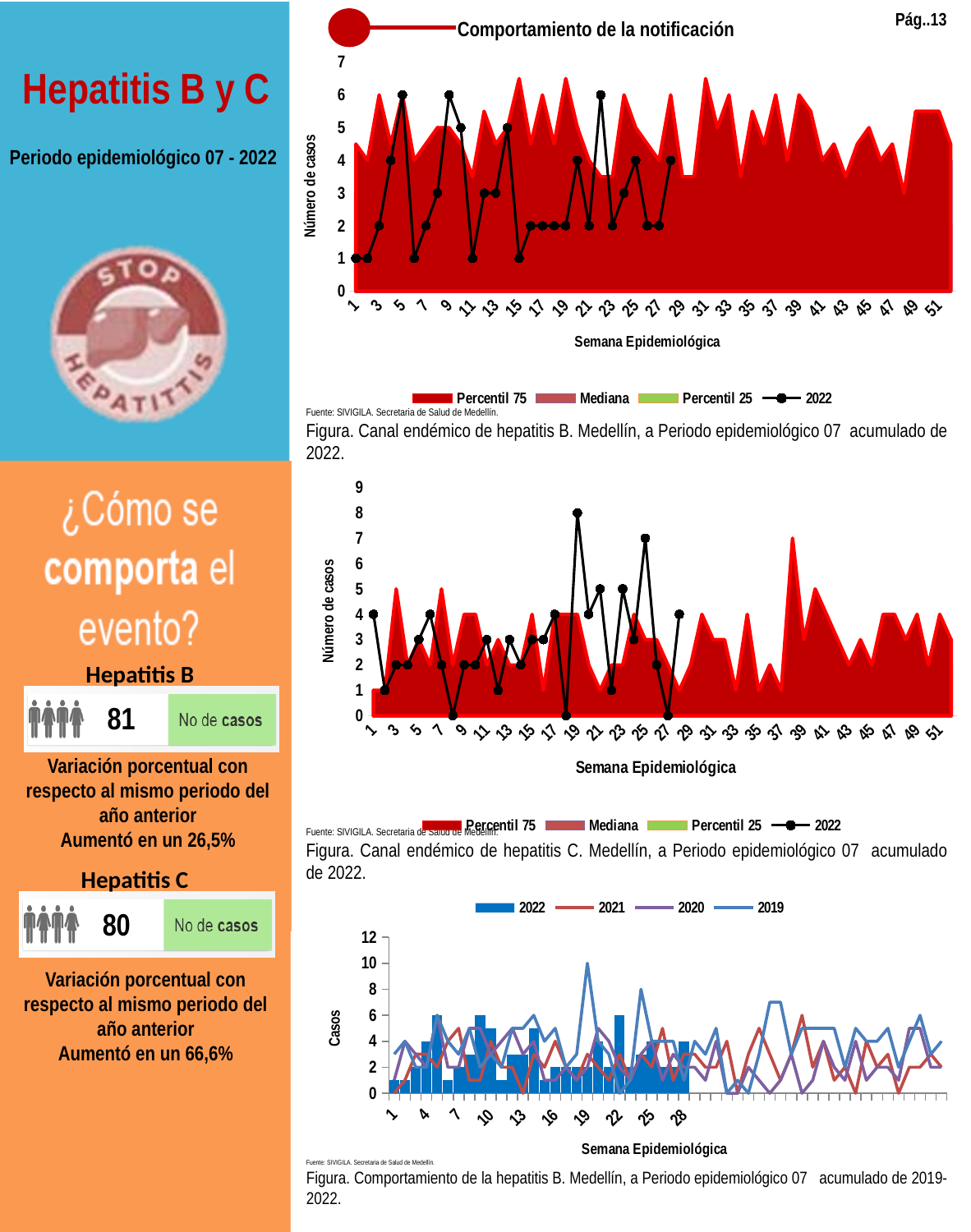
In the hepatitis C endemic channel chart (middle chart), what is the lowest value reached by the 2022 line? 0 In the hepatitis C endemic channel chart (middle chart), what is the difference between the 2022 values at week 19 and week 25? 1 In the hepatitis C endemic channel chart (middle chart), is the 2022 value at week 25 greater or less than 5? greater In the hepatitis C endemic channel chart (middle chart), at which epidemiological week does the 2022 line reach its highest value? 19 In the hepatitis B endemic channel chart (top chart), what is the 2022 value at epidemiological week 5? 6 In the hepatitis C endemic channel chart (middle chart), what is the 2022 value at epidemiological week 19? 8 In the bottom chart (Comportamiento de la hepatitis B 2019-2022), what is the 2019 value at epidemiological week 19? 10 How many series does the legend of the bottom chart (Comportamiento de la hepatitis B 2019-2022) list? 4 In the hepatitis B endemic channel chart (top chart), which has the larger 2022 value: week 5 or week 6? Week 5 In the hepatitis B endemic channel chart (top chart), what is the 2022 value at epidemiological week 1? 1 What is the x-axis title of the hepatitis B endemic channel chart (top chart)? Semana Epidemiológica How many series does the legend of the hepatitis B endemic channel chart (top chart) list? 4